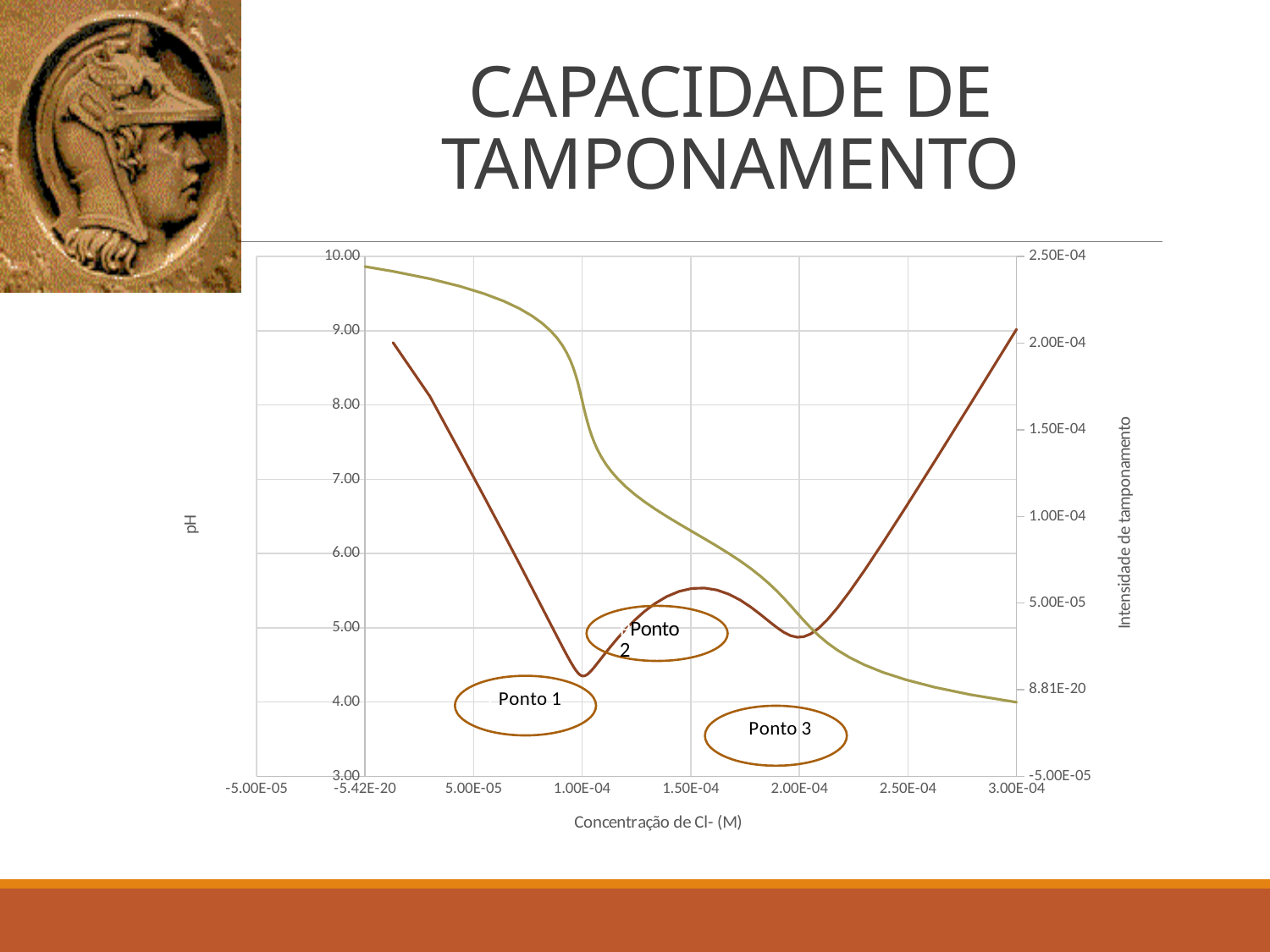
Is the pH value at a Cl- concentration of 1.50E-04 greater or less than 6.00? greater What is the label of the x axis of the chart? Concentração de Cl- (M) Is the pH value at a Cl- concentration of 5.00E-05 greater or less than 9.00? greater What kind of chart is shown on the slide? line chart At which Cl- concentration on the x axis does the Intensidade de tamponamento line reach its highest value? 3.00E-04 Is the Intensidade de tamponamento value at a Cl- concentration of 1.00E-04 greater or less than 5.00E-05? less Does the pH line rise or fall as the concentration of Cl- increases along the x axis? falls At which Cl- concentration on the x axis does the Intensidade de tamponamento line reach its lowest value? 1.00E-04 How many lines are plotted on the chart? 2 What is the title of the chart on the slide? CAPACIDADE DE TAMPONAMENTO